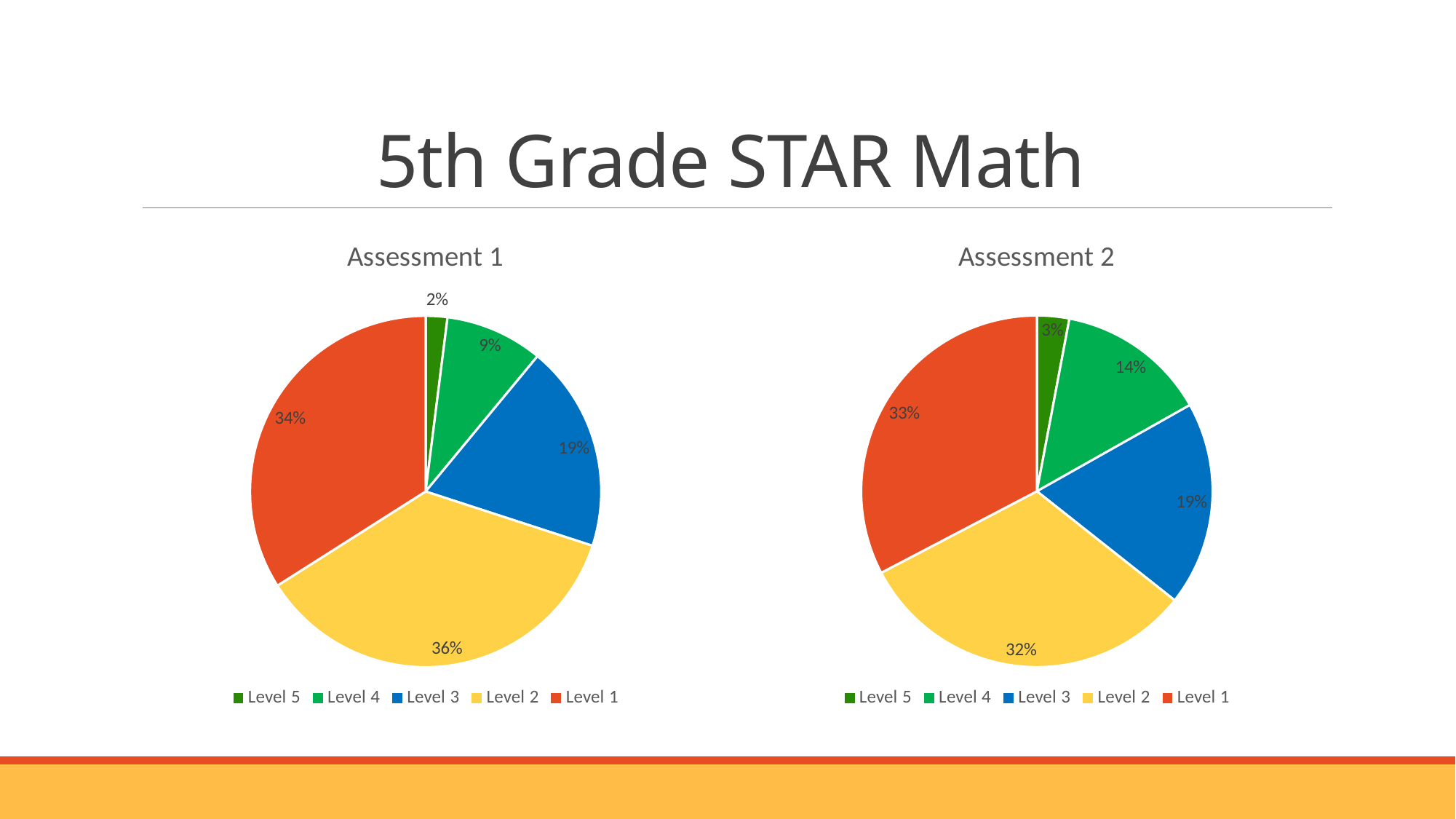
What type of chart is used for Assessment 2? Pie chart In the Assessment 2 chart, which level has the smallest slice? Level 5 In the Assessment 2 chart, what percentage is shown for Level 4? 14% In the Assessment 1 chart, which level has the largest slice? Level 2 In the Assessment 2 chart, which level has the largest slice? Level 1 In the Assessment 1 chart, what percentage is shown for Level 5? 2% In the Assessment 1 chart, what colour is the Level 1 slice? Red In the Assessment 2 chart, what percentage is shown for Level 1? 33% What is the difference between the Level 4 percentages in Assessment 2 and Assessment 1? 5% In the Assessment 1 chart, which is larger: the Level 3 slice or the Level 4 slice? Level 3 In the Assessment 1 chart, what percentage is shown for Level 2? 36% How many slices does the Assessment 1 pie chart have? 5